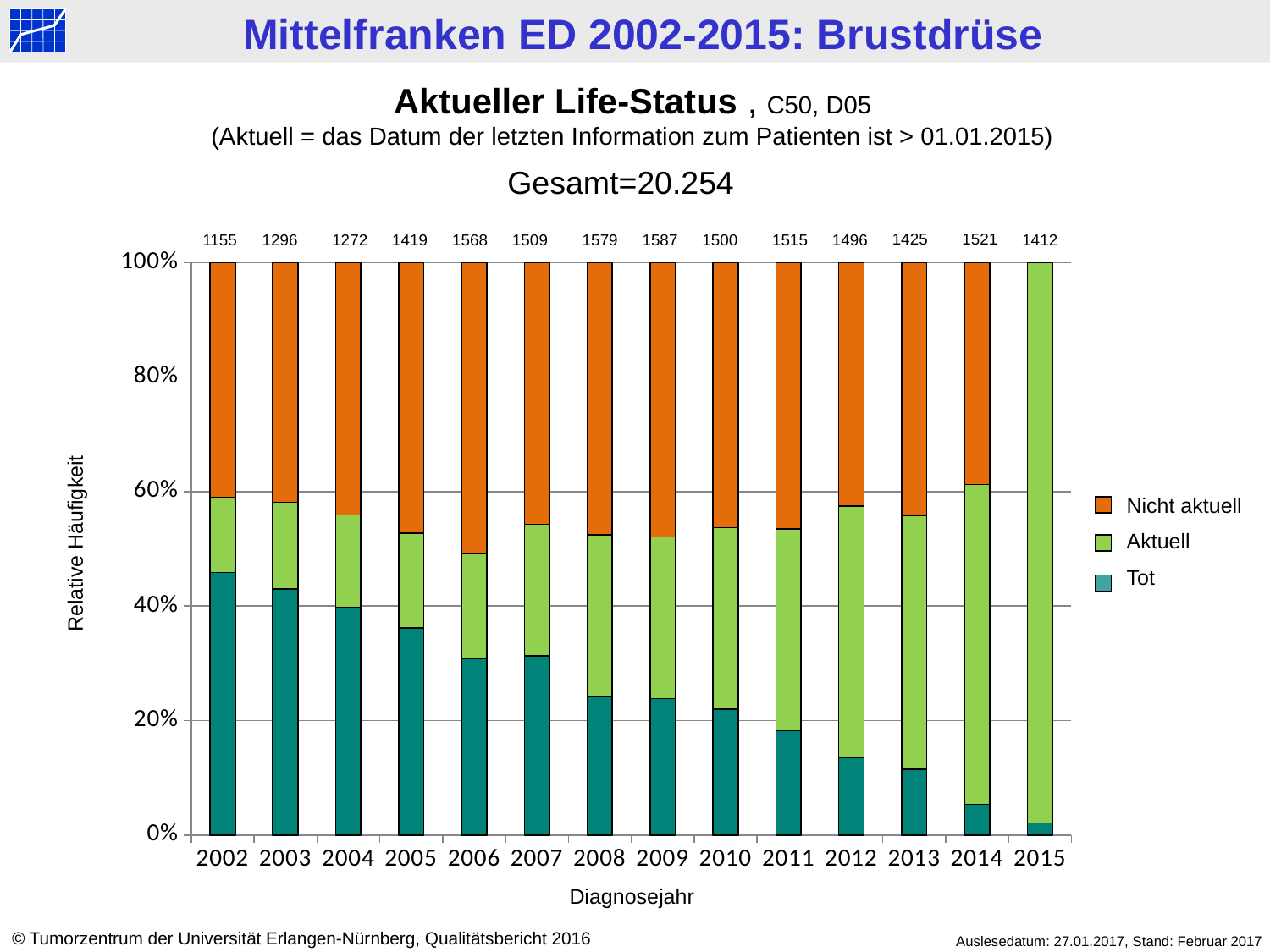
How many diagnosis years are shown on the x axis? 14 Is the 'Tot' share for 2002 greater or less than 40%? greater What is the difference between the numbers printed above the bars for 2014 and 2013? 96 What is the label of the x axis? Diagnosejahr What number is printed above the bar for 2002? 1155 What kind of chart is shown on the slide? bar chart Which year has the lowest number printed above its bar? 2002 Does the 'Tot' share rise or fall from 2002 to 2015? fall What number is printed above the bar for 2009? 1587 Which year has the highest number printed above its bar? 2009 Which year has the larger number printed above its bar, 2006 or 2007? 2006 How many series does the legend list? 3